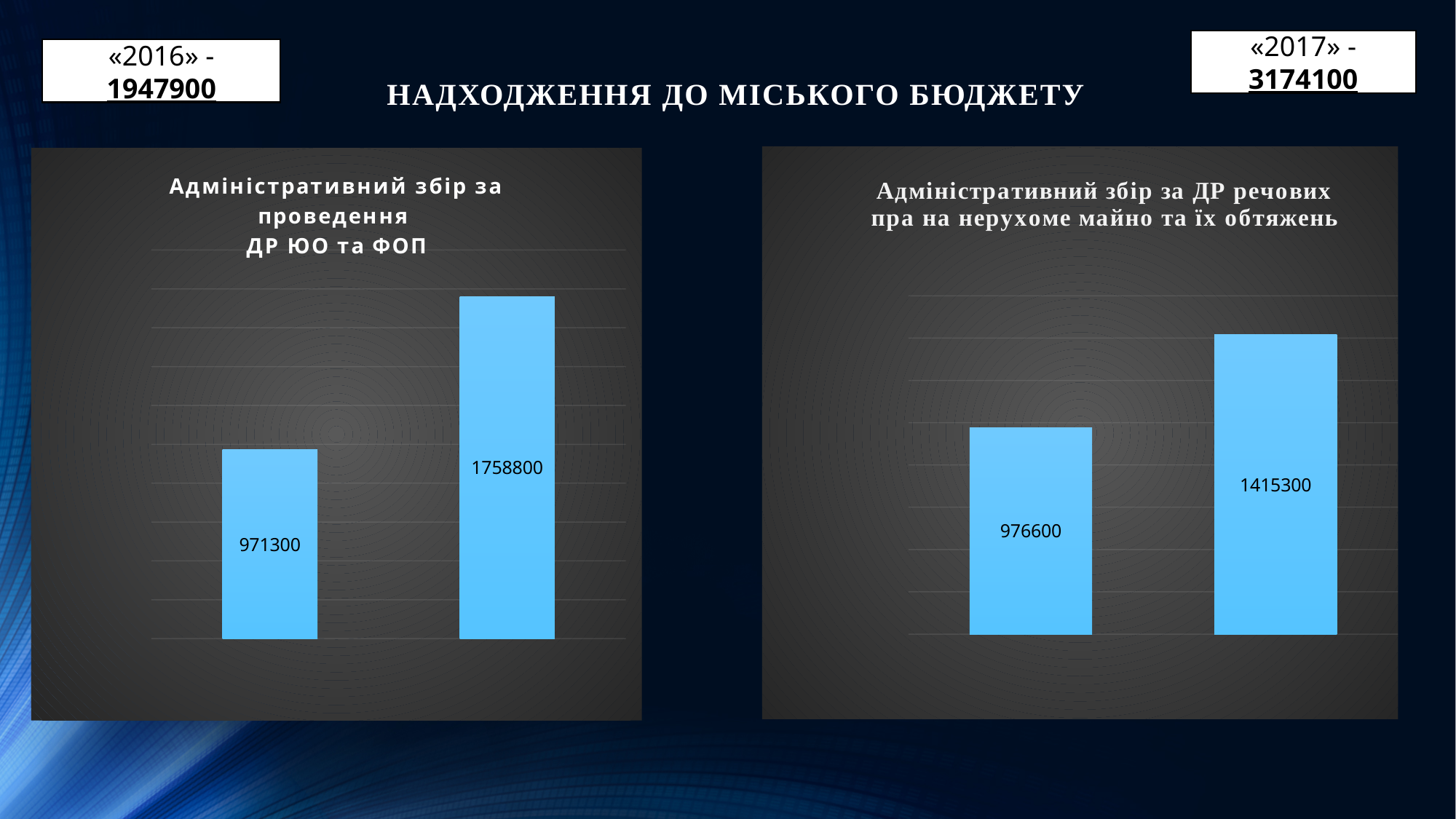
How many bars are plotted in the right chart? 2 In the left chart, which bar is the highest? The right bar (1758800) In the right chart (Адміністративний збір за ДР речових пра на нерухоме майно та їх обтяжень), what is the value shown on the left bar? 976600 In the left chart, what is the difference between the right bar and the left bar? 787500 In the right chart, do the values rise or fall from the left bar to the right bar? Rise In the left chart (Адміністративний збір за проведення ДР ЮО та ФОП), what is the value shown on the right bar? 1758800 What type of chart is the left chart on the slide? Bar chart In the right chart, which bar is the lowest? The left bar (976600) In the right chart (Адміністративний збір за ДР речових пра на нерухоме майно та їх обтяжень), what is the value shown on the right bar? 1415300 In the left chart (Адміністративний збір за проведення ДР ЮО та ФОП), what is the value shown on the left bar? 971300 Which is larger: the right bar of the left chart or the right bar of the right chart? The right bar of the left chart (1758800) In the right chart, what is the difference between the right bar and the left bar? 438700